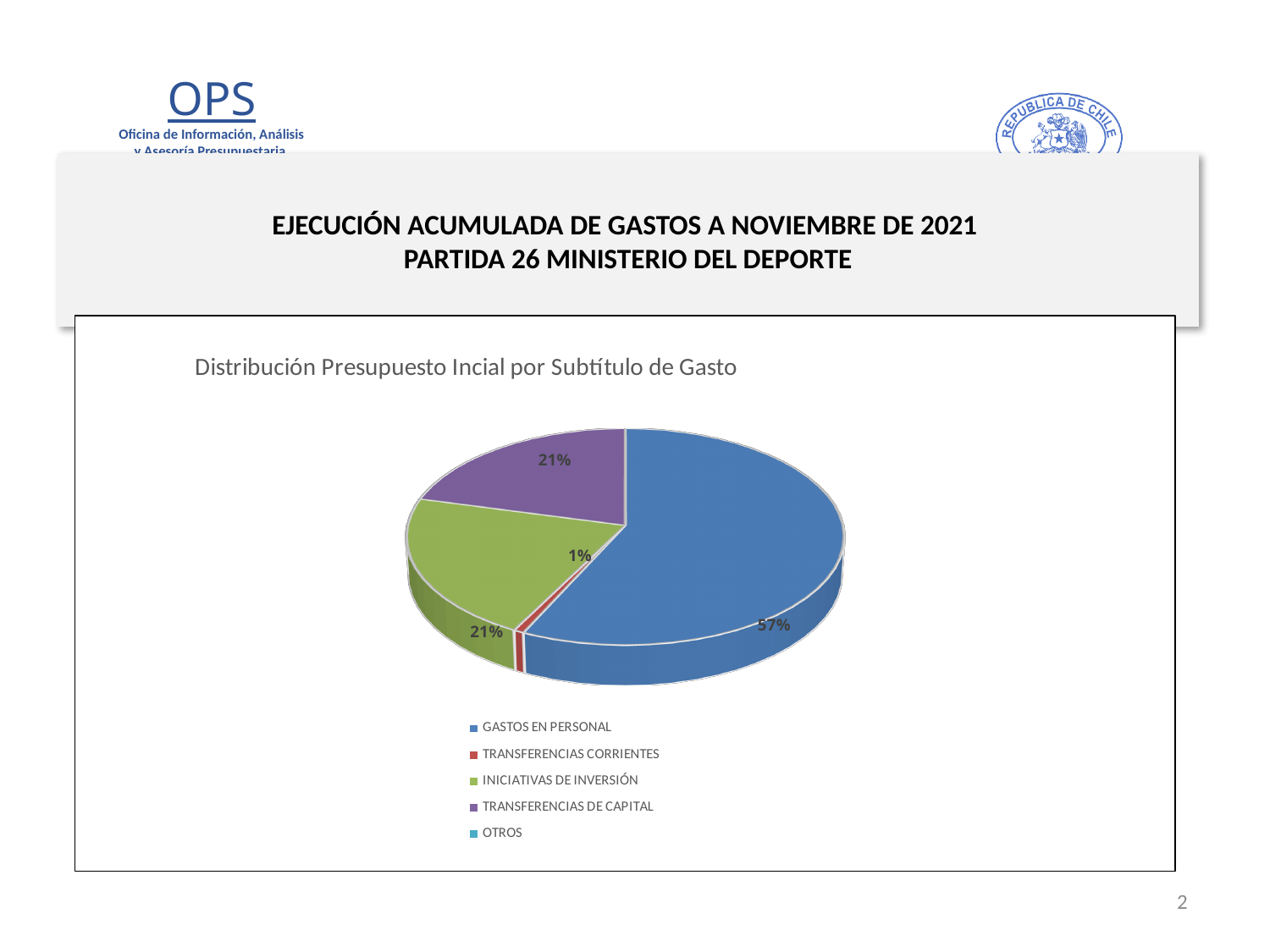
What colour is the GASTOS EN PERSONAL slice? Blue What percentage is shown for TRANSFERENCIAS CORRIENTES? 1% What percentage is shown for TRANSFERENCIAS DE CAPITAL? 21% What is the difference in percentage points between GASTOS EN PERSONAL and INICIATIVAS DE INVERSIÓN? 36 percentage points What type of chart is shown on the slide? Pie chart Which category has the largest slice of the pie? GASTOS EN PERSONAL Which is larger, the share for GASTOS EN PERSONAL or the share for TRANSFERENCIAS DE CAPITAL? GASTOS EN PERSONAL Is the share for GASTOS EN PERSONAL greater or less than 50%? greater What is the title of the chart? Distribución Presupuesto Incial por Subtítulo de Gasto What share of the pie does GASTOS EN PERSONAL represent? 57% How many entries does the legend list? 5 What percentage is shown for INICIATIVAS DE INVERSIÓN? 21%